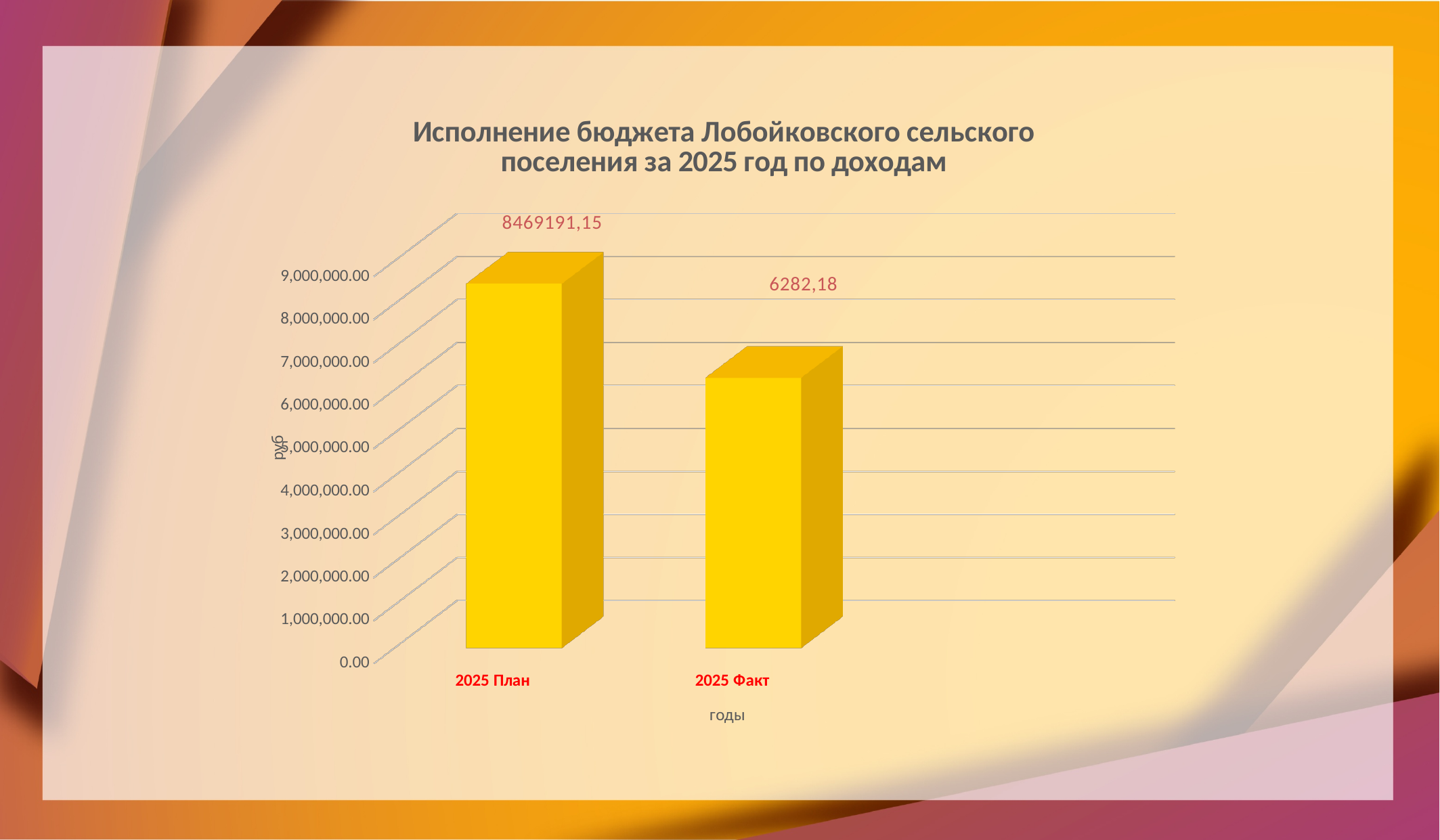
Which category has the taller bar? 2025 План What is the title of the chart? Исполнение бюджета Лобойковского сельского поселения за 2025 год по доходам Is the bar for 2025 Факт greater or less than 7,000,000.00 on the axis? less What value is shown for 2025 Факт? 6282,18 How many bars are plotted in the chart? 2 What is the label of the vertical axis? руб What kind of chart is shown on the slide? Bar chart Which bar is taller, 2025 План or 2025 Факт? 2025 План What value is shown for 2025 План? 8469191,15 Is the bar for 2025 План greater or less than 8,000,000.00 on the axis? greater Do the bar values rise or fall from 2025 План to 2025 Факт? Fall Which category has the shorter bar? 2025 Факт